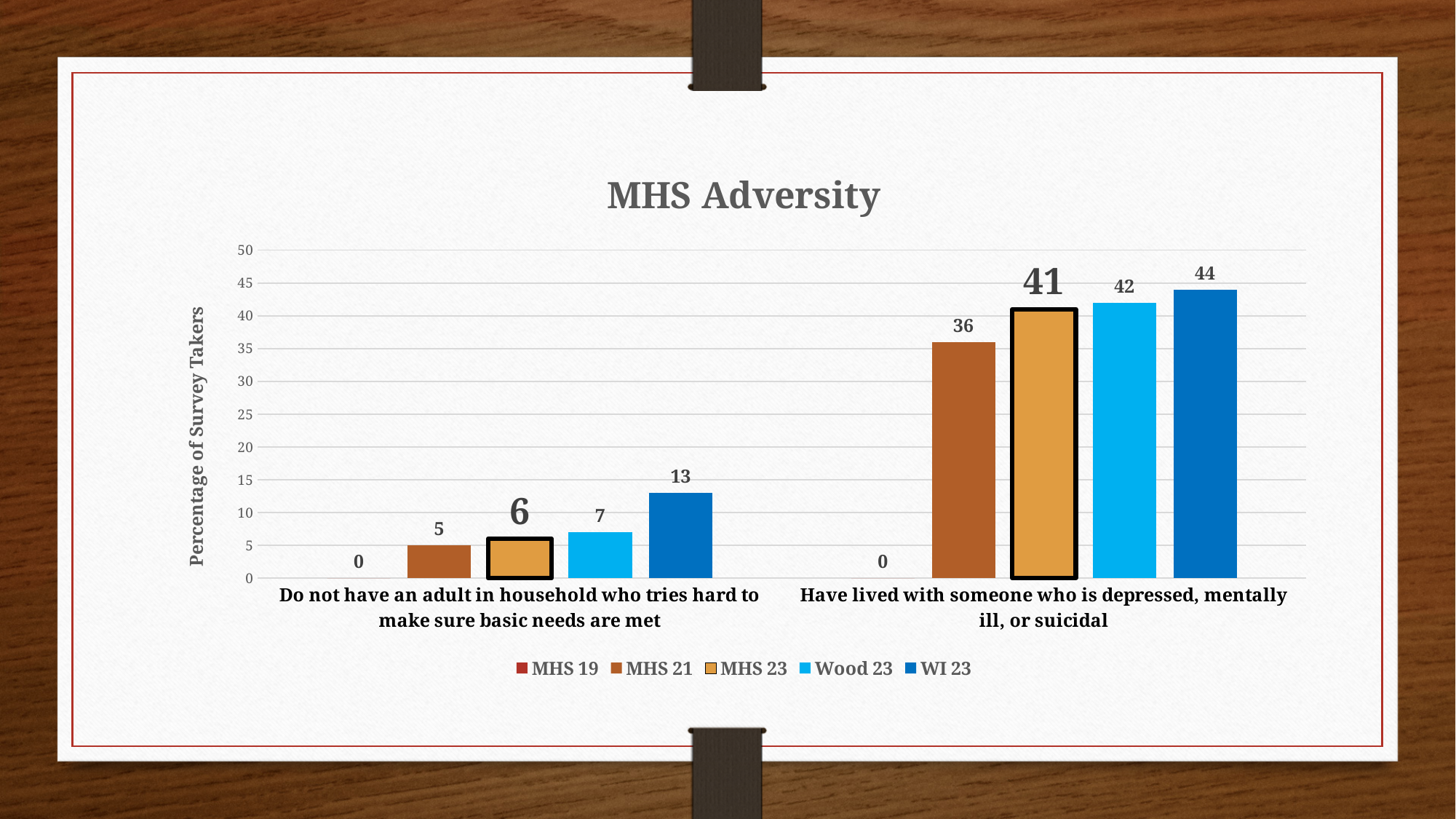
Which series has the lowest value in the category 'Do not have an adult in household who tries hard to make sure basic needs are met'? MHS 19 What is the value for MHS 19 in the category 'Do not have an adult in household who tries hard to make sure basic needs are met'? 0 What is the value for MHS 23 in the category 'Have lived with someone who is depressed, mentally ill, or suicidal'? 41 What is the value for WI 23 in the category 'Do not have an adult in household who tries hard to make sure basic needs are met'? 13 What is the difference between the WI 23 and MHS 21 values in the category 'Have lived with someone who is depressed, mentally ill, or suicidal'? 8 What kind of chart is shown on the slide? Bar chart How many categories are shown on the x axis? 2 How many series does the legend list? 5 Which series has the highest value in the category 'Have lived with someone who is depressed, mentally ill, or suicidal'? WI 23 What is the value for MHS 21 in the category 'Have lived with someone who is depressed, mentally ill, or suicidal'? 36 What is the title of the chart? MHS Adversity Which is larger in the category 'Do not have an adult in household who tries hard to make sure basic needs are met': Wood 23 or MHS 21? Wood 23